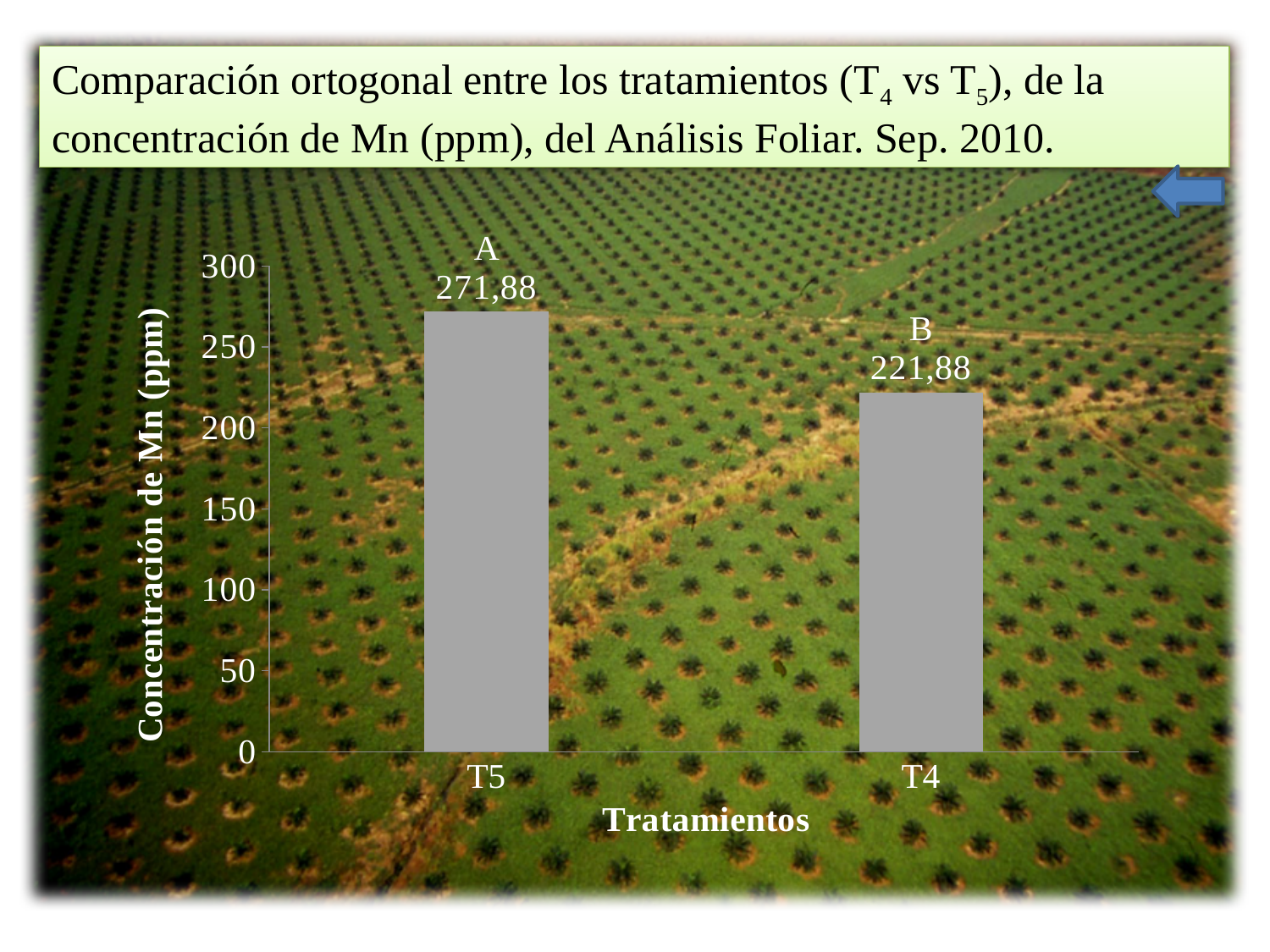
What is the Mn concentration value shown for treatment T4? 221,88 What kind of chart is shown on the slide? bar chart Which treatment has the lowest Mn concentration? T4 Which has a larger Mn concentration, T4 or T5? T5 Which treatment has the highest Mn concentration? T5 How many treatments are plotted in the chart? 2 What is the difference in Mn concentration between T5 and T4? 50 Is the value for T5 greater or less than 250? greater What letter is printed above the T4 bar? B What is the label of the y axis? Concentración de Mn (ppm) Is the value for T4 greater or less than 250? less What is the Mn concentration value shown for treatment T5? 271,88